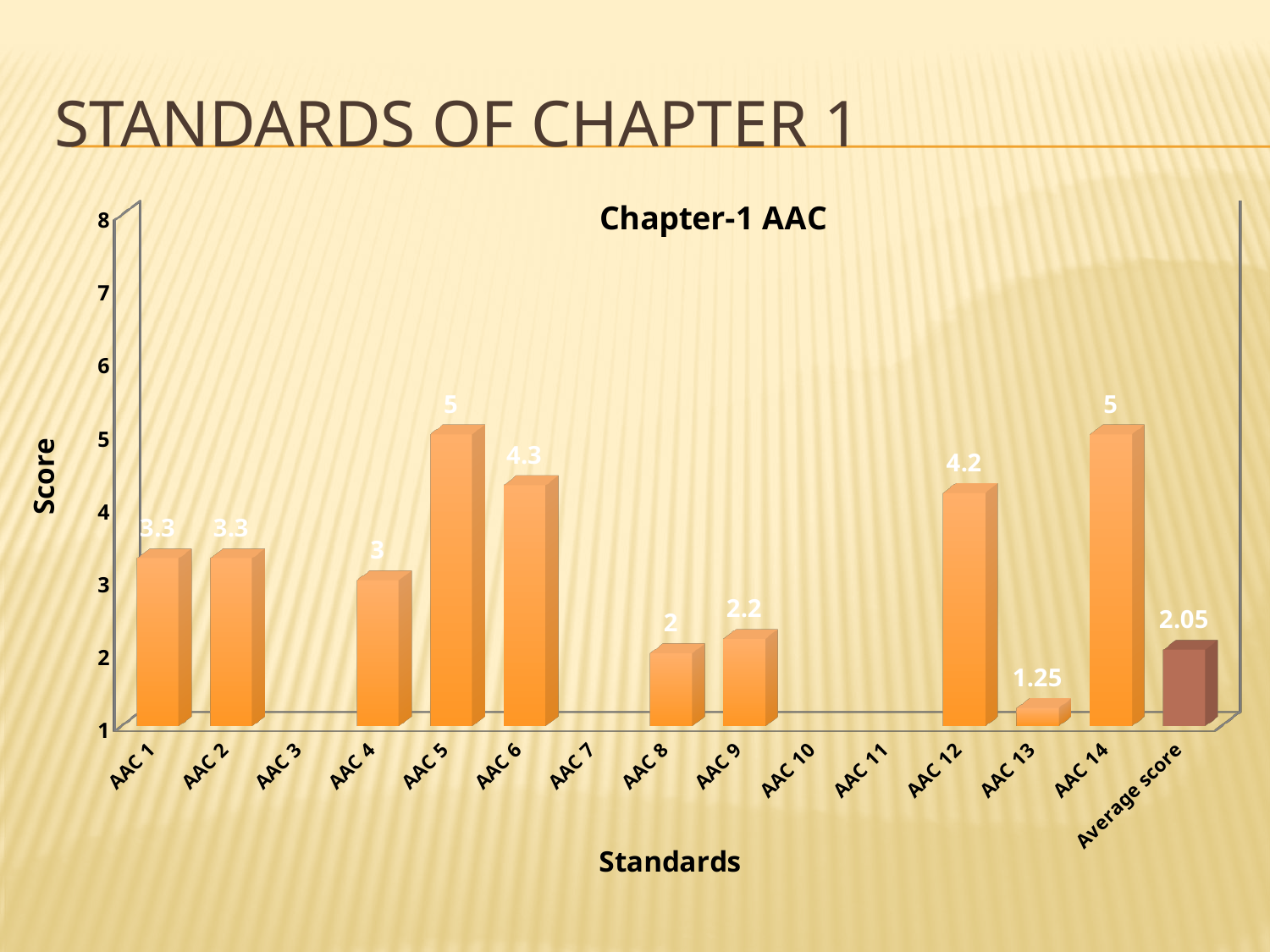
What is the label of the y axis in the Chapter-1 AAC chart? Score How many categories are listed on the x axis of the Chapter-1 AAC chart? 15 What is the difference between the scores for AAC 9 and AAC 8 in the Chapter-1 AAC chart? 0.2 What is the score for AAC 5 in the Chapter-1 AAC chart? 5 What is the score for AAC 12 in the Chapter-1 AAC chart? 4.2 What is the difference between the scores for AAC 5 and AAC 13 in the Chapter-1 AAC chart? 3.75 In the Chapter-1 AAC chart, is the score for AAC 13 greater or less than 2? less Among the bars plotted in the Chapter-1 AAC chart, which standard has the lowest score? AAC 13 What kind of chart is the Chapter-1 AAC chart? bar chart What is the score for AAC 13 in the Chapter-1 AAC chart? 1.25 In the Chapter-1 AAC chart, which has the higher score, AAC 5 or AAC 9? AAC 5 What is the Average score shown in the Chapter-1 AAC chart? 2.05